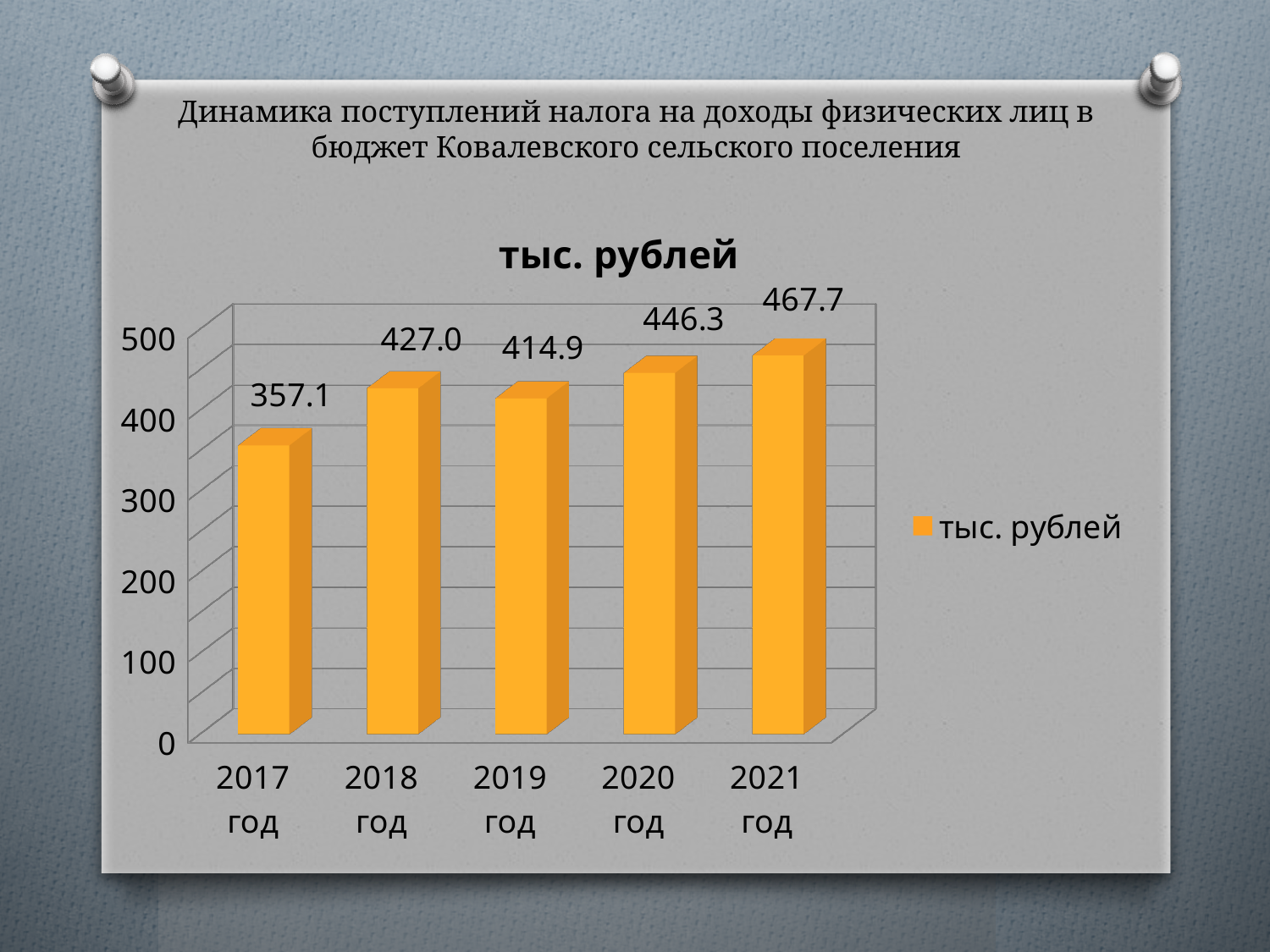
What is the difference between the values for 2018 год and 2019 год? 12.1 How many years are shown on the x axis? 5 What is the title of the chart? тыс. рублей Which year has the lowest value? 2017 год What is the value for 2019 год? 414.9 What is the value for 2017 год? 357.1 Is the value for 2020 год greater or less than 400? greater Which is larger, the value for 2018 год or the value for 2019 год? 2018 год What is the difference between the values for 2021 год and 2017 год? 110.6 What kind of chart is shown on the slide? bar chart What is the value for 2021 год? 467.7 Which year has the highest value? 2021 год